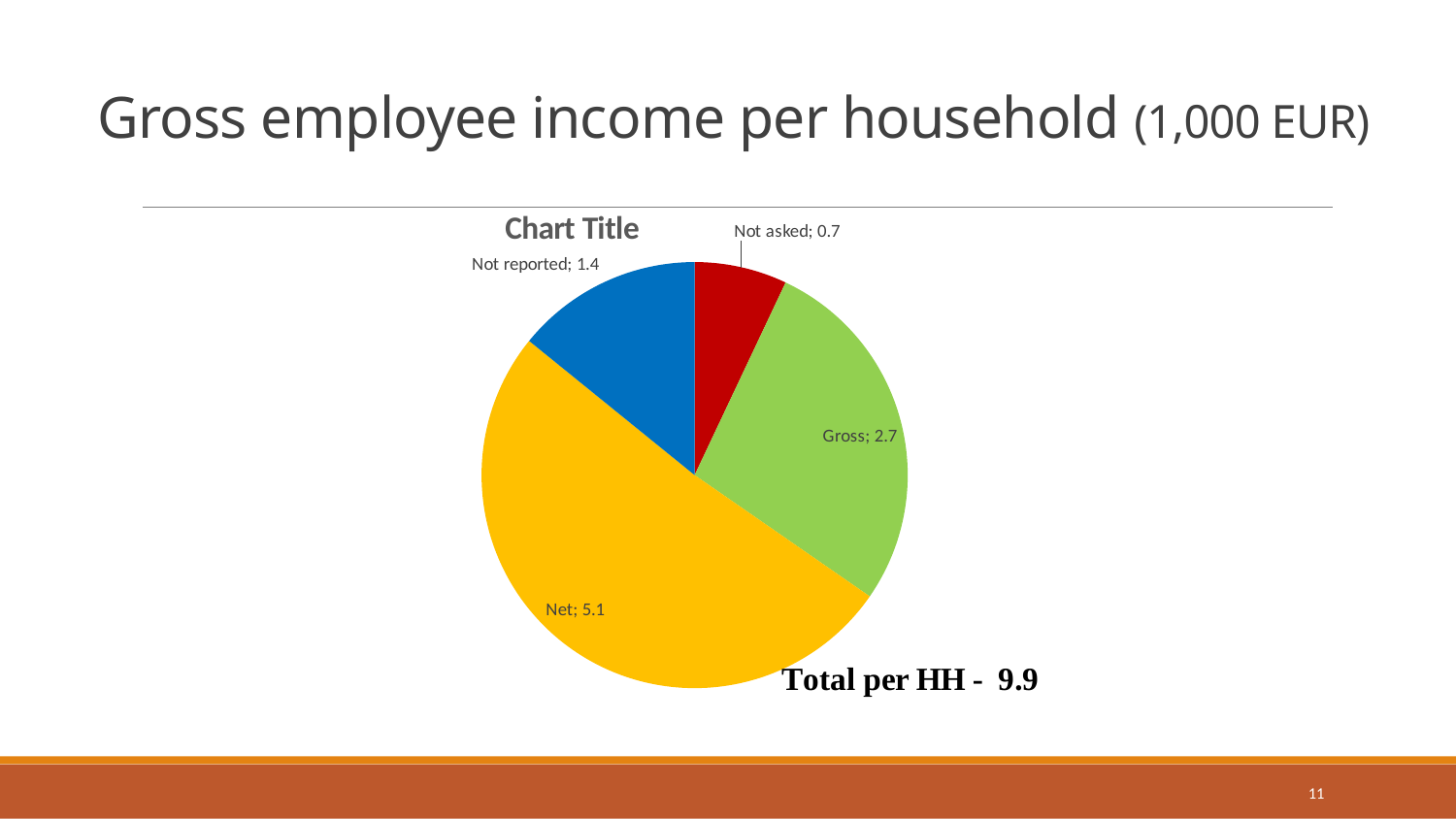
What is the value for Not reported in the pie chart? 1.4 Which category has the smallest slice of the pie chart? Not asked What is the value for Not asked in the pie chart? 0.7 What total per household is stated next to the pie chart? 9.9 Which is larger in the pie chart, Not reported or Not asked? Not reported Which category has the largest slice of the pie chart? Net What kind of chart is shown on the slide? Pie chart What is the difference between the Net and Gross values in the pie chart? 2.4 What colour is the Net slice in the pie chart? Yellow How many slices does the pie chart have? 4 What is the value for Gross in the pie chart? 2.7 What is the value for Net in the pie chart? 5.1